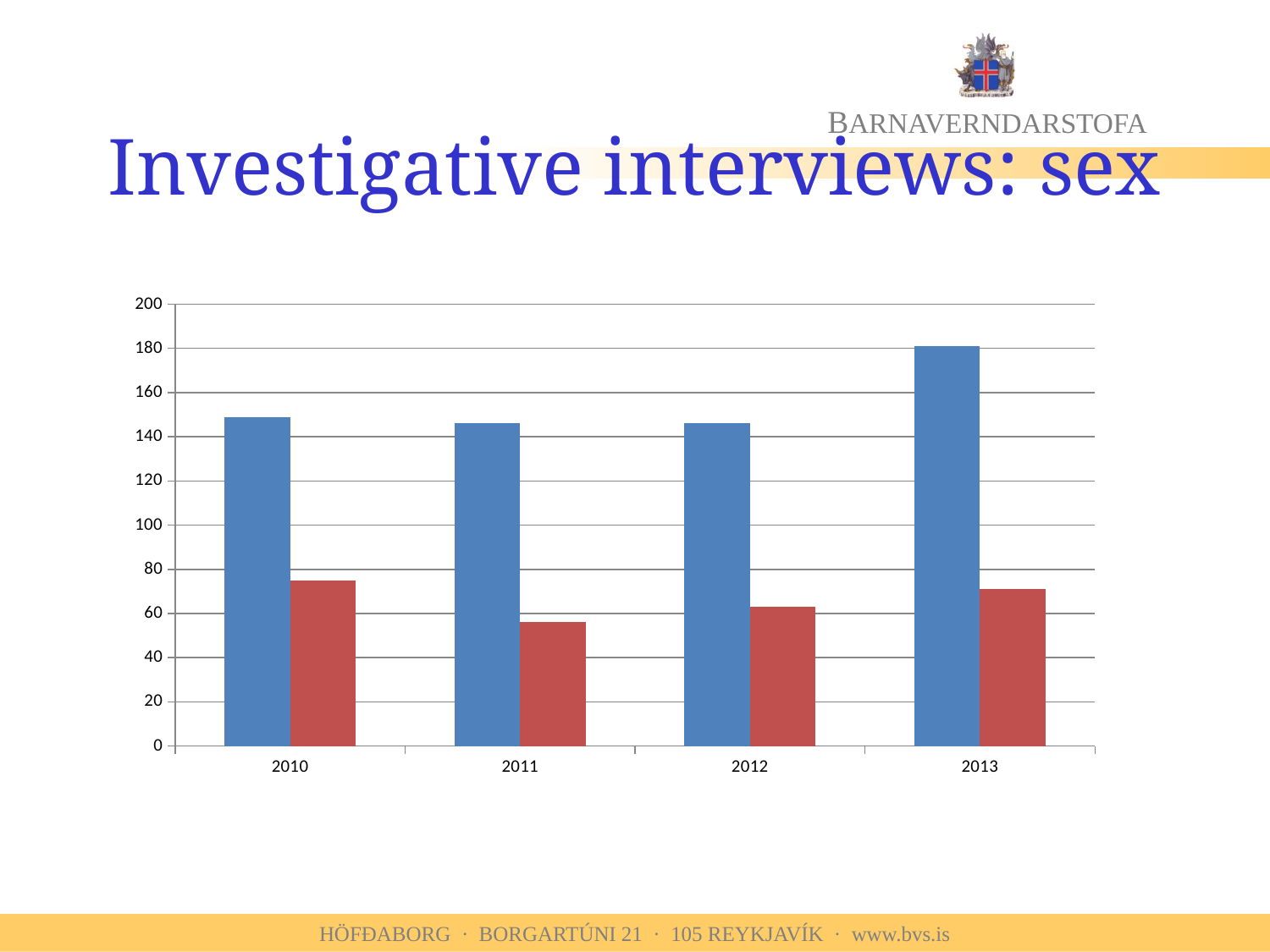
How many years are shown on the x axis of the chart? 4 What is the title of the slide containing the chart? Investigative interviews: sex Is the value of the red bar for 2011 greater or less than 60? less In which year is the red bar the shortest? 2011 In which year is the blue bar the tallest? 2013 Is the value of the blue bar for 2013 greater or less than 160? greater What kind of chart is shown on the slide? bar chart In 2013, which bar is taller, the blue one or the red one? the blue one Is the value of the blue bar for 2010 greater or less than 160? less Which is taller, the red bar for 2011 or the red bar for 2012? the red bar for 2012